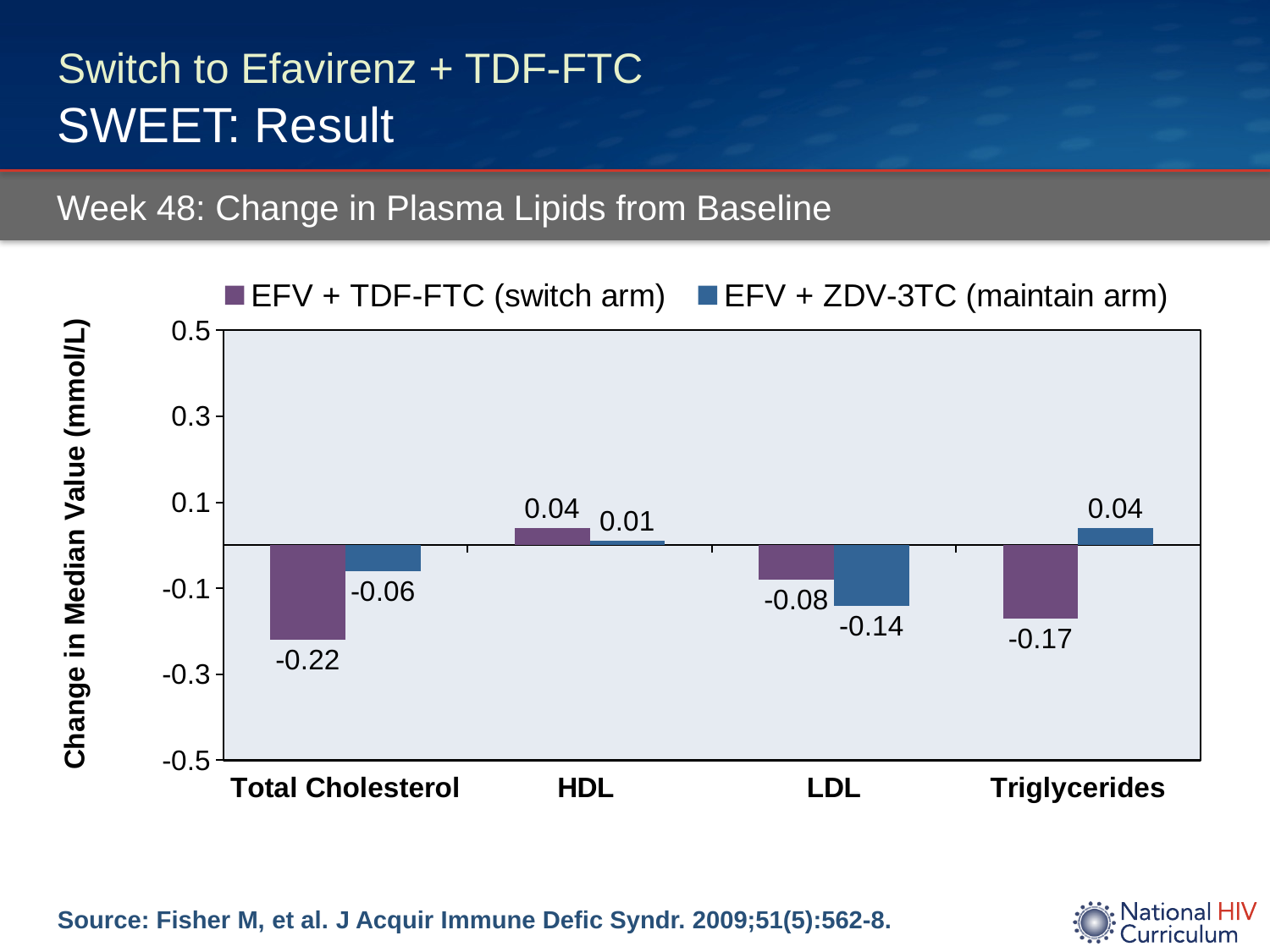
How many lipid categories are shown on the x axis? 4 How many series does the legend list? 2 What is the change in median value for Total Cholesterol in the EFV + TDF-FTC (switch arm) series? -0.22 What is the difference between the switch arm and maintain arm values for Total Cholesterol? 0.16 What is the label of the y axis? Change in Median Value (mmol/L) For LDL, which series has the larger decrease, the switch arm or the maintain arm? EFV + ZDV-3TC (maintain arm) What kind of chart is shown on the slide? Bar chart What is the change in median value for LDL in the EFV + ZDV-3TC (maintain arm) series? -0.14 What is the change in median value for Triglycerides in the EFV + TDF-FTC (switch arm) series? -0.17 Which category has the highest value in the EFV + ZDV-3TC (maintain arm) series? Triglycerides What is the change in median value for HDL in the EFV + ZDV-3TC (maintain arm) series? 0.01 Which category has the lowest value in the EFV + TDF-FTC (switch arm) series? Total Cholesterol